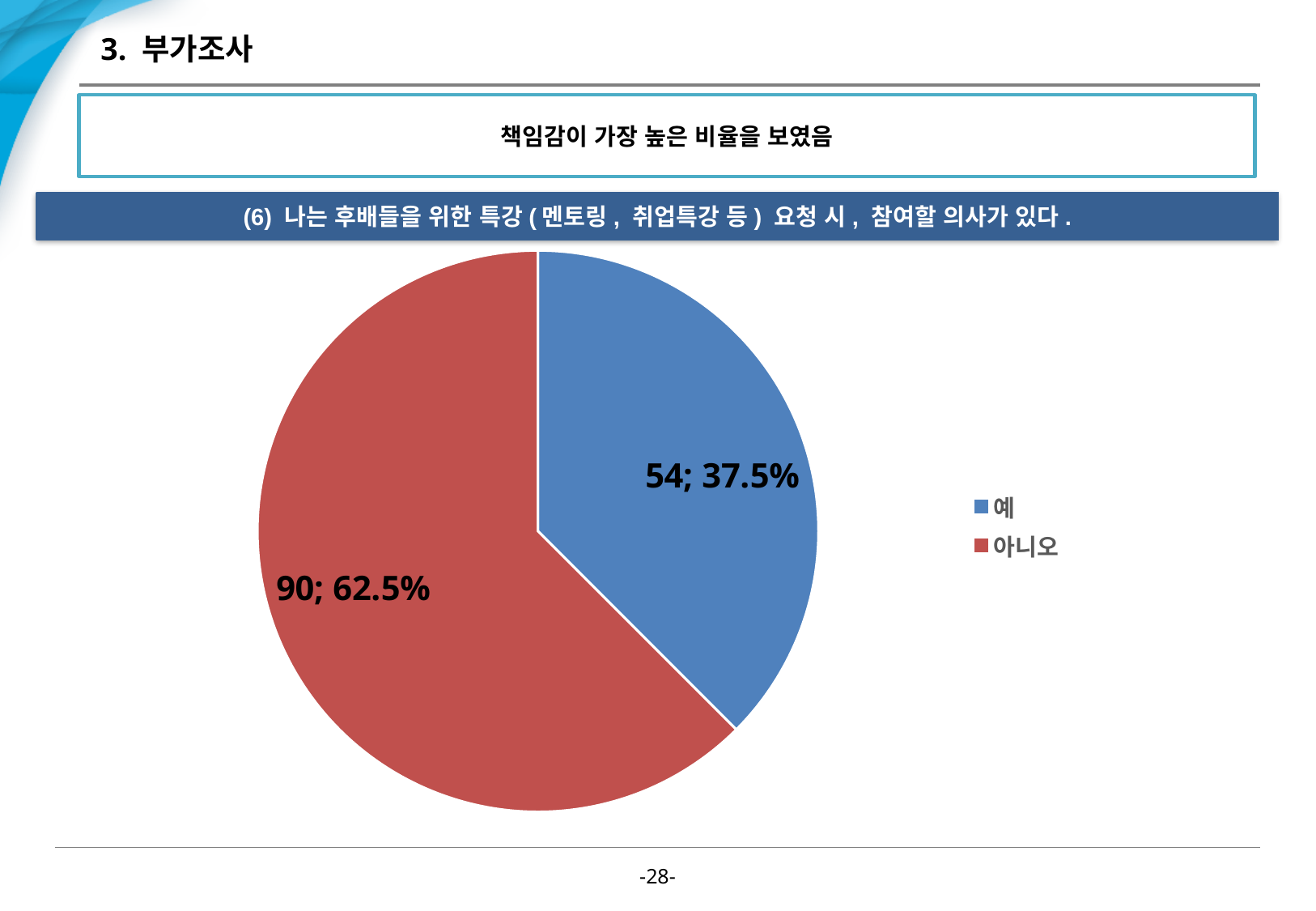
How many slices does the pie chart have? 2 Which category has the largest slice? 아니오 What share of the pie does 예 represent? 37.5% What kind of chart is shown on the slide? pie chart What is the count for 아니오 in the pie chart? 90 Which category has the smallest slice? 예 How many entries does the legend list? 2 What colour is the 예 slice? blue What share of the pie does 아니오 represent? 62.5% What is the count for 예 in the pie chart? 54 Which is larger, the count for 예 or the count for 아니오? 아니오 What is the difference in count between 아니오 and 예? 36